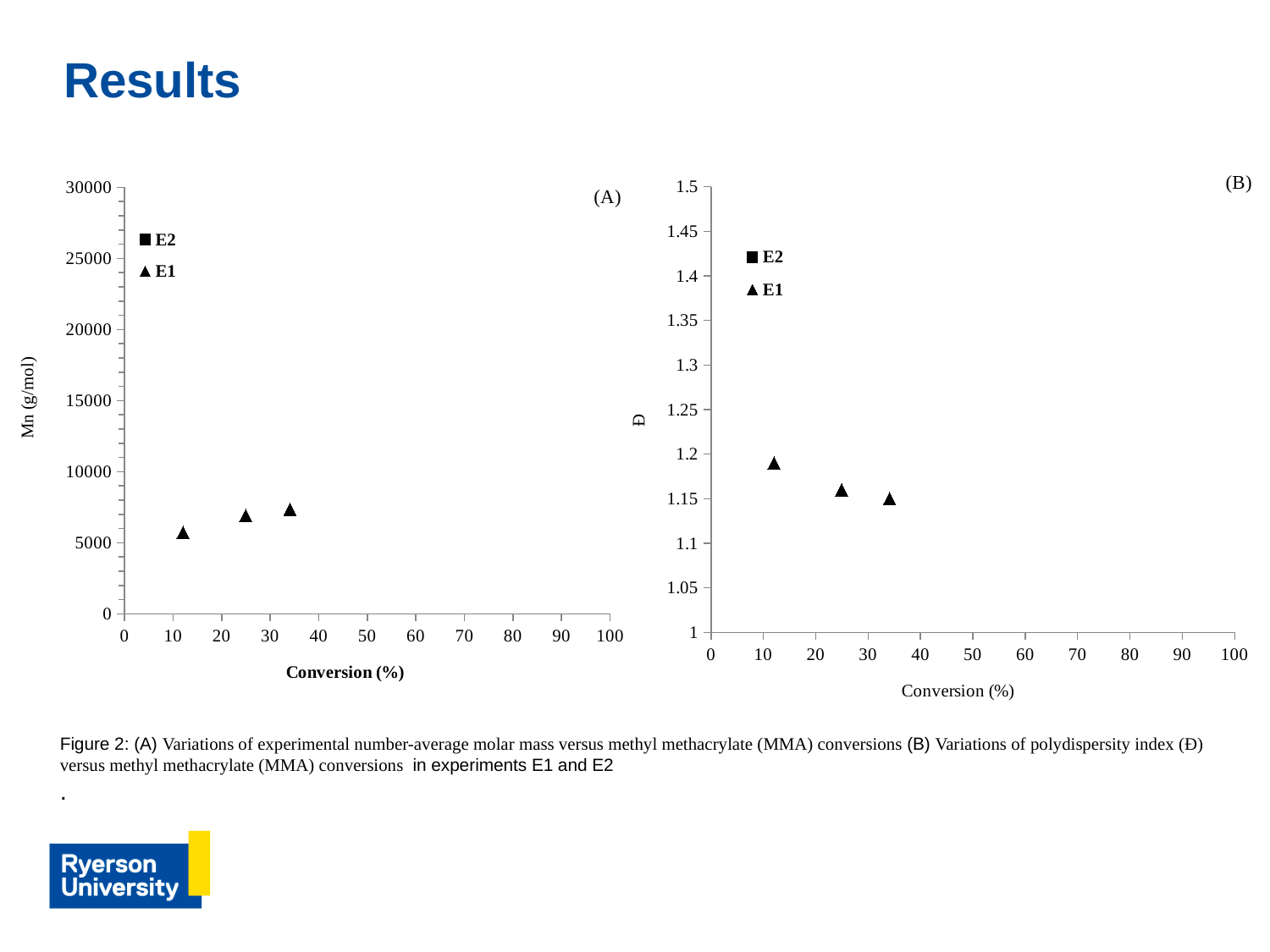
What kind of chart is chart (B) on the right? scatter chart How many E1 data points are plotted in chart (B)? 3 In chart (B), is the Đ value for the E1 point at about 12% conversion greater or less than 1.25? less In chart (A), is the Mn value for the E1 point at about 34% conversion greater or less than 10000? less How many E1 data points are plotted in chart (A)? 3 What is the x-axis title of chart (A)? Conversion (%) How many series does the legend of chart (B) list? 2 In chart (A), is the Mn value for the E1 point at about 12% conversion greater or less than 5000? greater How many series does the legend of chart (A) list? 2 In chart (B), do the E1 values of Đ rise or fall as conversion increases? fall In chart (A), do the E1 values of Mn rise or fall as conversion increases? rise What kind of chart is chart (A) on the left? scatter chart